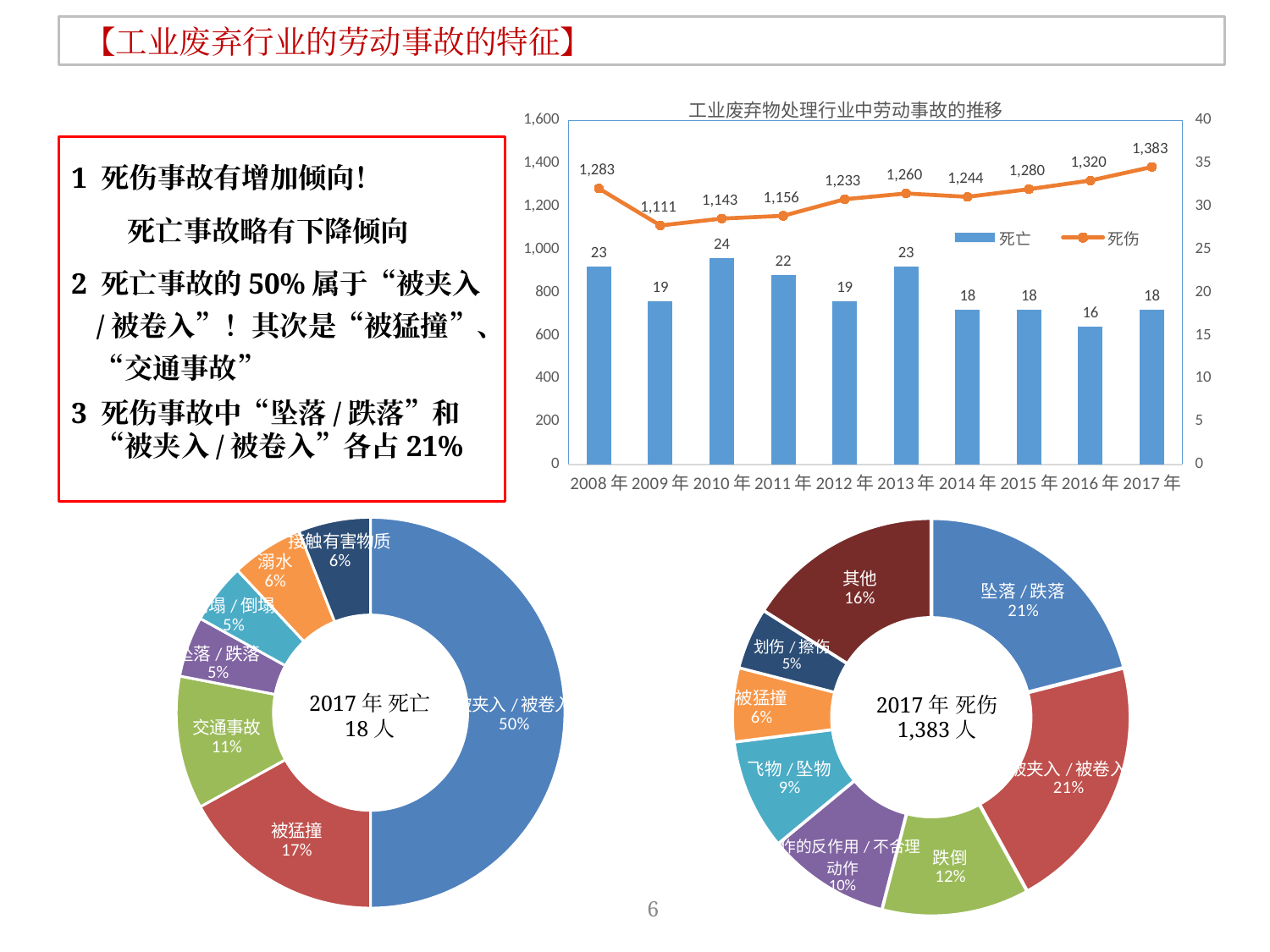
In the chart titled 工业废弃物处理行业中劳动事故的推移, how many years are shown on the x axis? 10 In the chart titled 工业废弃物处理行业中劳动事故的推移, which year has the lowest 死亡 value? 2016年 In the bottom-right donut chart (2017年 死伤 1,383人), which category has the smallest share? 划伤/擦伤 In the chart titled 工业废弃物处理行业中劳动事故的推移, which year has the larger 死伤 value, 2009年 or 2010年? 2010年 In the bottom-right donut chart (2017年 死伤 1,383人), what share does 跌倒 have? 12% What kind of chart is the chart titled 工业废弃物处理行业中劳动事故的推移? Combined bar and line chart In the chart titled 工业废弃物处理行业中劳动事故的推移, what is the 死亡 value for 2010年? 24 In the bottom-left donut chart (2017年 死亡 18人), what share does 被夹入/被卷入 have? 50% In the chart titled 工业废弃物处理行业中劳动事故的推移, what is the 死伤 value for 2017年? 1,383 In the chart titled 工业废弃物处理行业中劳动事故的推移, which year has the highest 死亡 value? 2010年 In the chart titled 工业废弃物处理行业中劳动事故的推移, how many series does the legend list? 2 In the chart titled 工业废弃物处理行业中劳动事故的推移, what is the difference between the 死伤 values for 2017年 and 2008年? 100